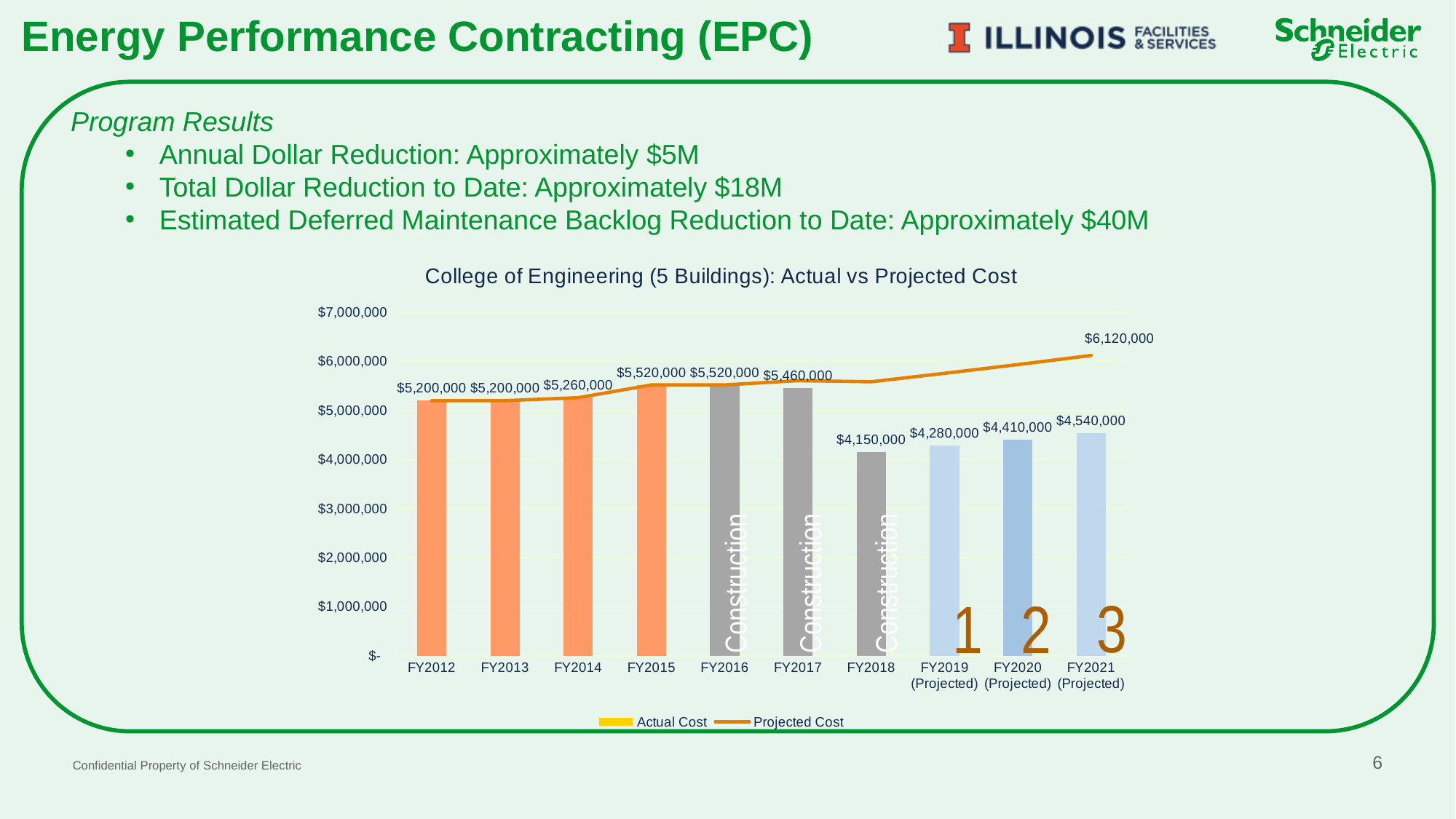
What is the value of the Projected Cost line at FY2021 (Projected)? $6,120,000 What is the difference between the Projected Cost line value and the bar value at FY2021 (Projected)? $1,580,000 How many series does the legend list? 2 How many fiscal years are shown on the x axis? 10 Do the bar values rise or fall from FY2019 (Projected) to FY2021 (Projected)? rise Which fiscal year has the lowest bar value? FY2018 What is the bar value for FY2014? $5,260,000 What kind of chart is used to show the Actual Cost values? bar chart Which is larger, the bar value for FY2015 or the bar value for FY2019 (Projected)? FY2015 What is the Actual Cost value for FY2018? $4,150,000 What is the difference between the FY2017 bar value and the FY2018 bar value? $1,310,000 Is the bar value for FY2018 greater or less than $5,000,000? less